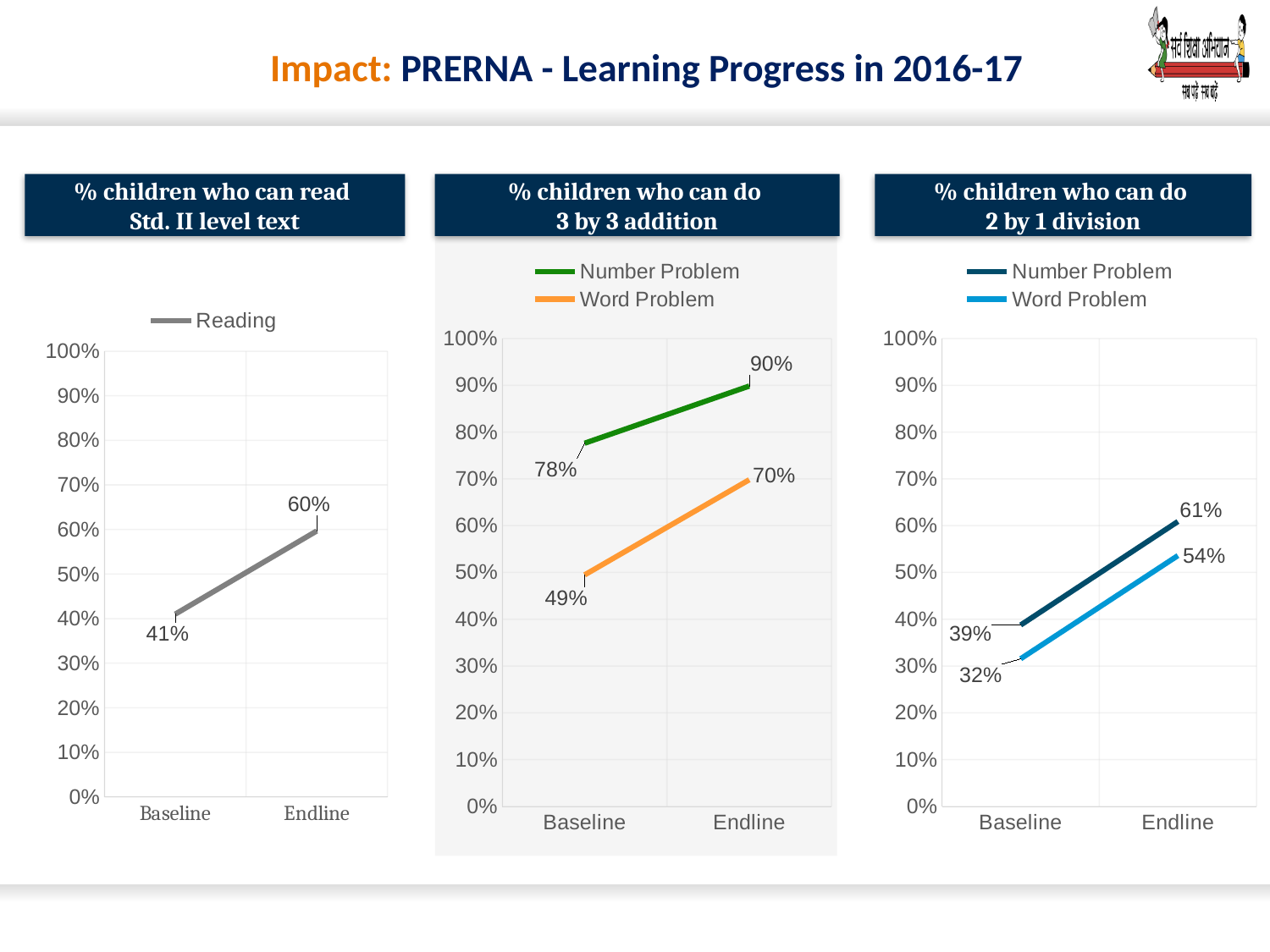
In the '% children who can do 2 by 1 division' chart, which series has the higher value at Endline, Number Problem or Word Problem? Number Problem In the '% children who can do 3 by 3 addition' chart, what is the Number Problem value at Endline? 90% In the '% children who can do 3 by 3 addition' chart, how many series does the legend list? 2 In the '% children who can read Std. II level text' chart, what is the Reading value at Endline? 60% In the '% children who can do 2 by 1 division' chart, what is the Word Problem value at Baseline? 32% In the '% children who can do 2 by 1 division' chart, what is the Number Problem value at Endline? 61% What kind of chart is the '% children who can read Std. II level text' chart? line chart In the '% children who can do 2 by 1 division' chart, do the values rise or fall from Baseline to Endline? rise In the '% children who can do 3 by 3 addition' chart, what is the difference between the Number Problem and Word Problem values at Endline? 20% In the '% children who can read Std. II level text' chart, what is the Reading value at Baseline? 41% In the '% children who can read Std. II level text' chart, what is the difference between the Endline and Baseline Reading values? 19% In the '% children who can do 3 by 3 addition' chart, what is the Word Problem value at Baseline? 49%